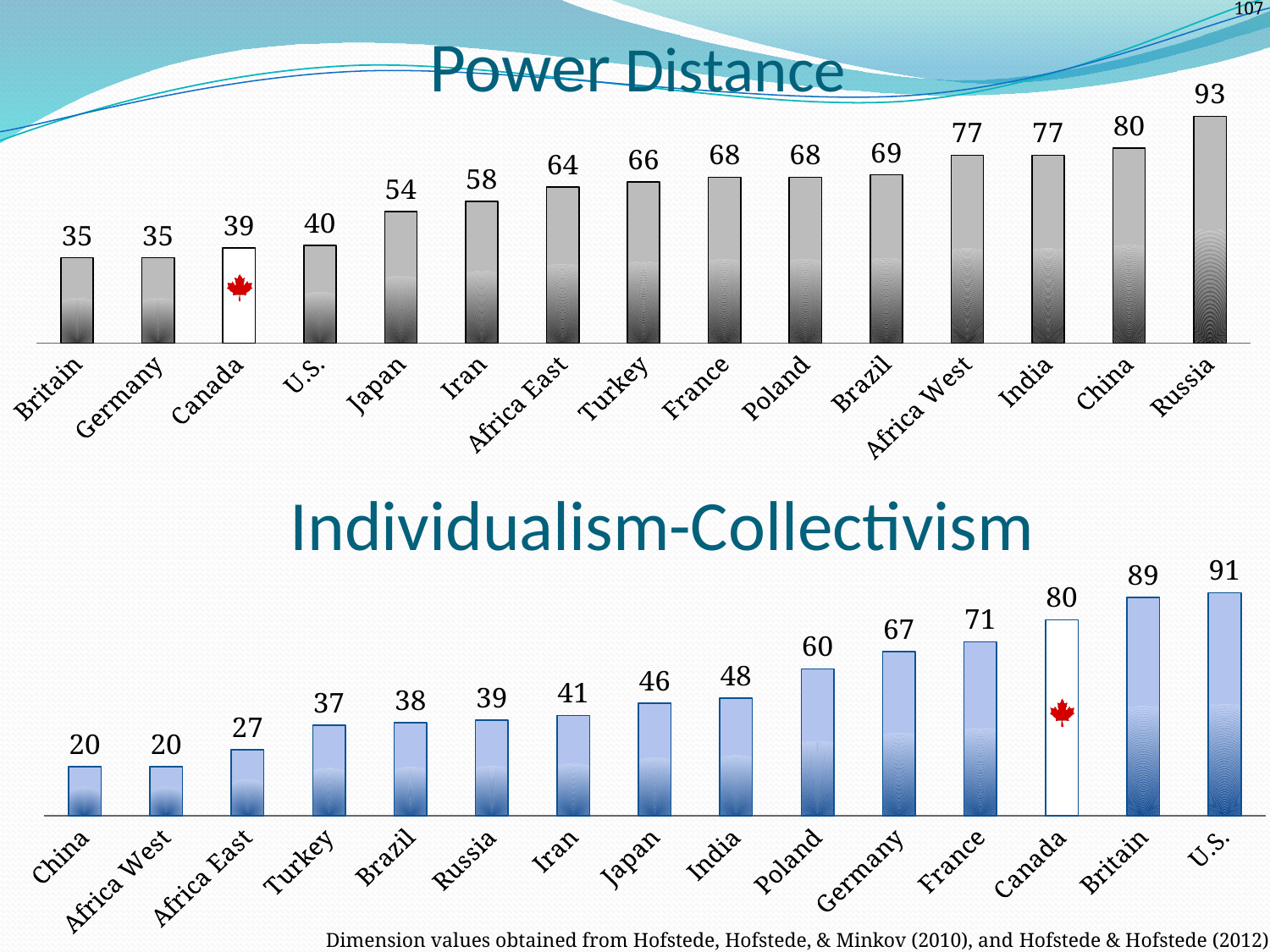
In the Power Distance chart, which bar is highlighted in white with a maple leaf? Canada In the Individualism-Collectivism chart, which country has the lowest value? China and Africa West (both 20) In the Individualism-Collectivism chart, which is larger, the value for Poland or the value for India? Poland In the Power Distance chart, what is the difference between the values for Russia and Canada? 54 In the Individualism-Collectivism chart, what is the value for Canada? 80 In the Power Distance chart, what is the value for Japan? 54 In the Individualism-Collectivism chart, do the values rise or fall from left to right? rise In the Power Distance chart, which is larger, the value for Iran or the value for U.S.? Iran In the Power Distance chart, which country has the highest value? Russia In the Power Distance chart, how many countries or regions are shown? 15 What kind of chart is the Individualism-Collectivism chart? bar chart In the Individualism-Collectivism chart, what is the difference between the values for U.S. and Britain? 2